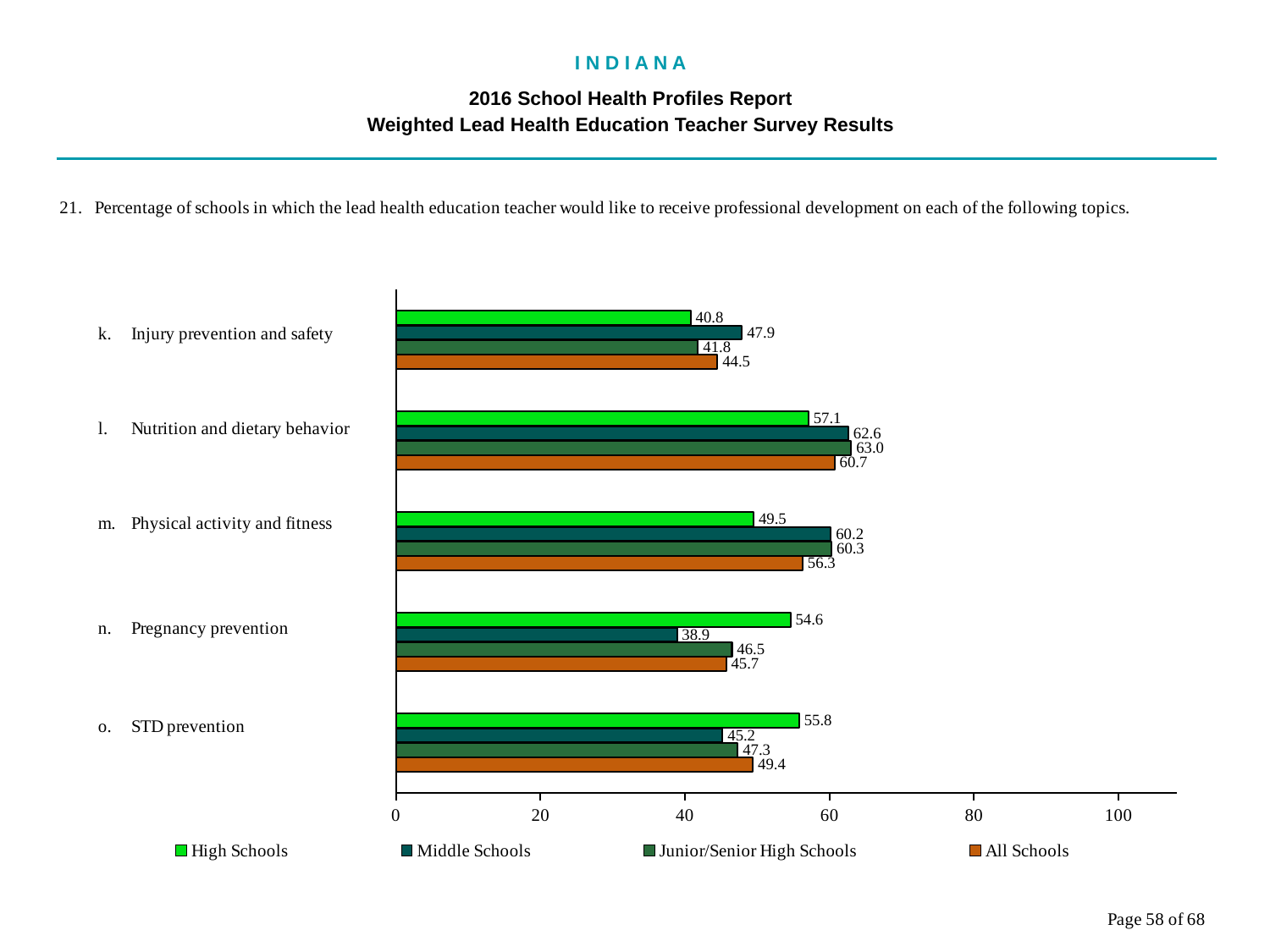
Which topic has the lowest value for High Schools? Injury prevention and safety What is the value for All Schools for Nutrition and dietary behavior? 60.7 What is the value for Middle Schools for Pregnancy prevention? 38.9 Which series is shown in orange in the legend? All Schools What kind of chart is shown on the slide? Bar chart Which is larger for Physical activity and fitness: the High Schools value or the Middle Schools value? Middle Schools What is the value for Junior/Senior High Schools for STD prevention? 47.3 Which topic has the highest value for All Schools? Nutrition and dietary behavior What is the value for High Schools for Injury prevention and safety? 40.8 How many series does the legend list? 4 How many topics are shown on the chart? 5 What is the difference between the High Schools and Middle Schools values for Pregnancy prevention? 15.7